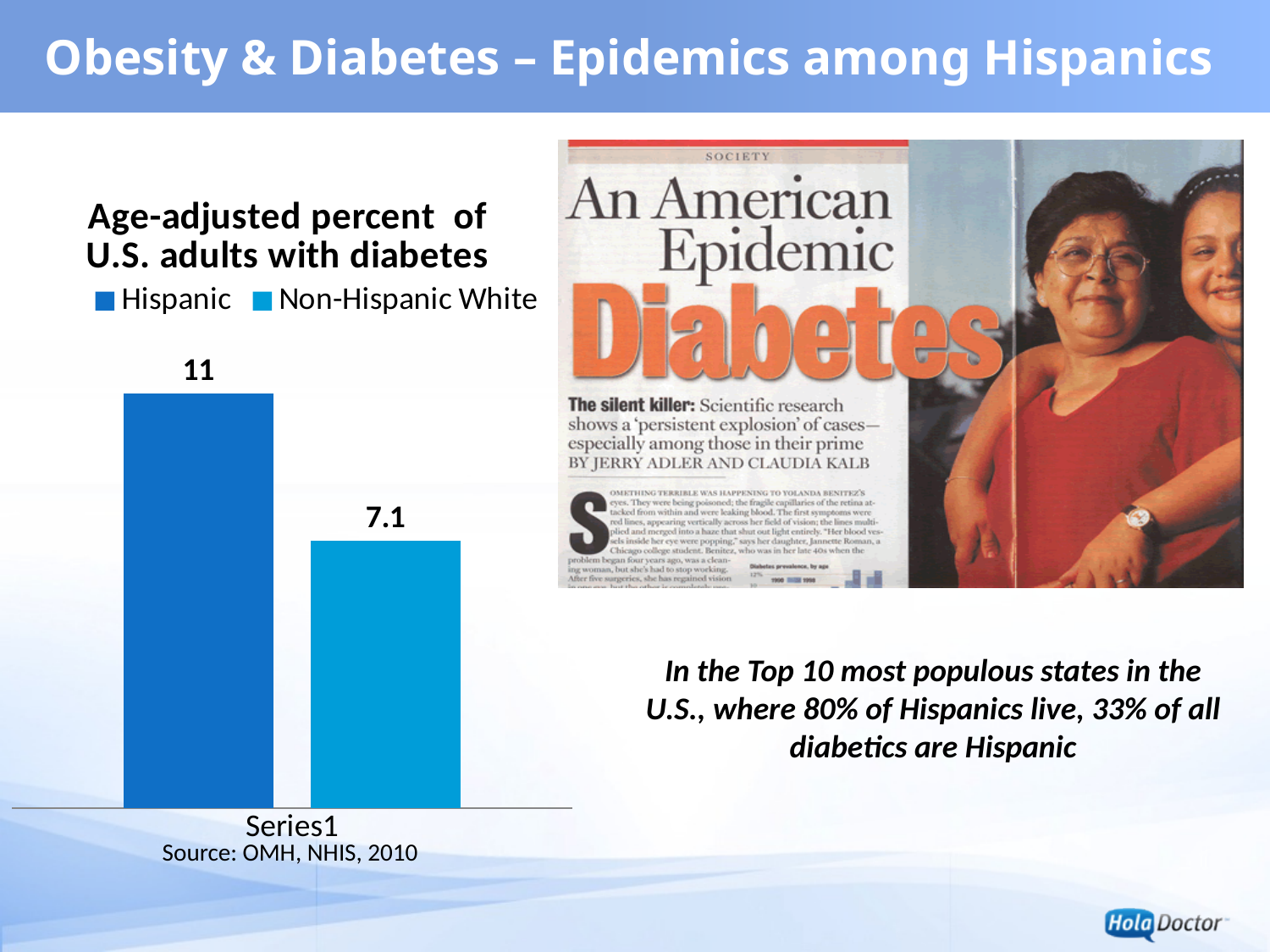
What is the title of the chart? Age-adjusted percent of U.S. adults with diabetes How many series does the chart legend list? 2 Which group has the lower age-adjusted percent of adults with diabetes? Non-Hispanic White What is the difference between the Hispanic and Non-Hispanic White values in the chart? 3.9 What kind of chart is shown on the slide? bar chart How many bars are plotted in the chart? 2 What source is cited below the chart? OMH, NHIS, 2010 What is the age-adjusted percent of U.S. adults with diabetes for Non-Hispanic White? 7.1 Is the value for Hispanic larger or smaller than the value for Non-Hispanic White? larger What is the age-adjusted percent of U.S. adults with diabetes for Hispanic? 11 Which group has the higher age-adjusted percent of adults with diabetes? Hispanic